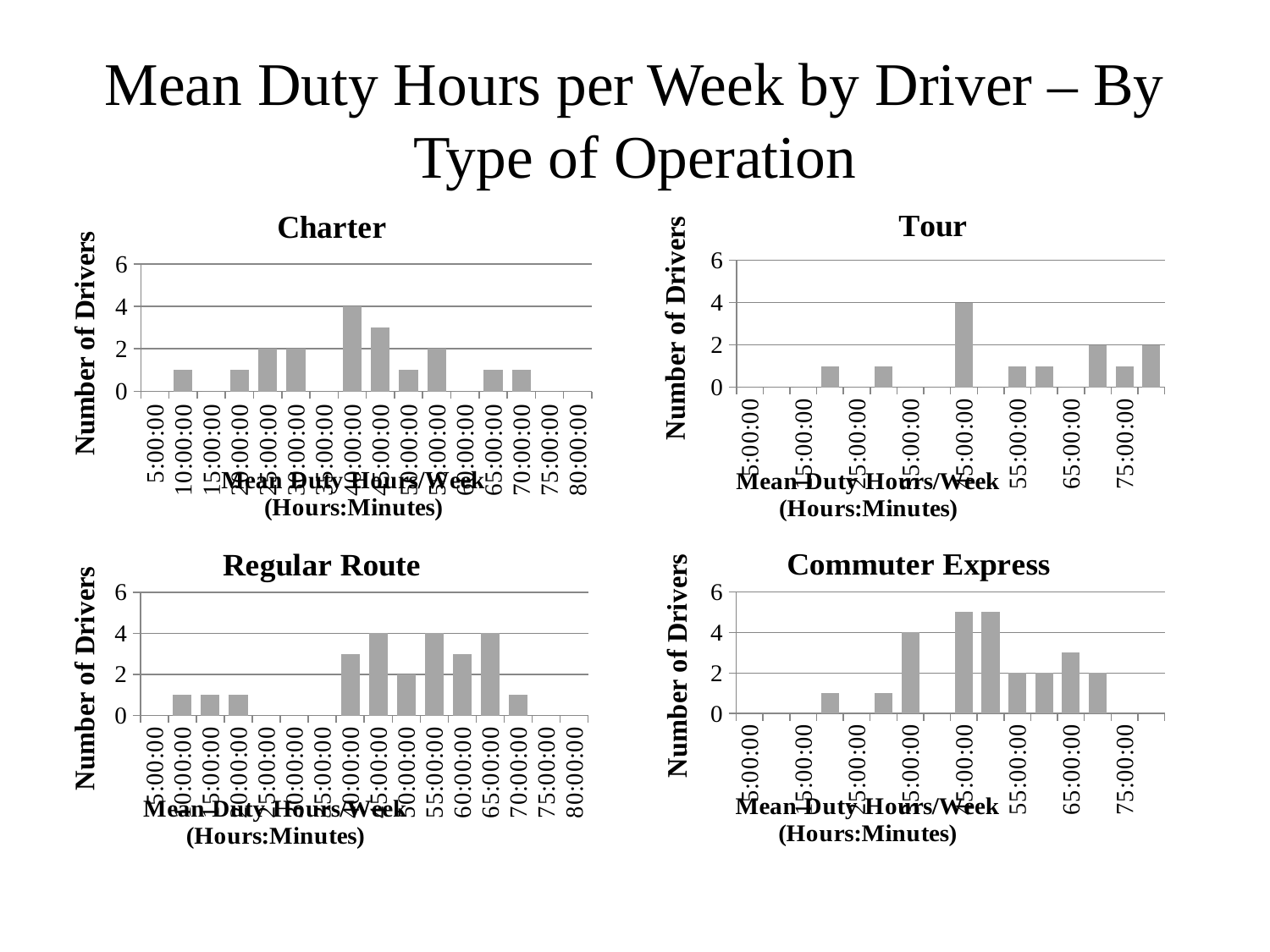
In the Commuter Express chart, is the number of drivers for 45:00:00 greater or less than 4? greater In the Charter chart, what is the difference in number of drivers between the 40:00:00 and 25:00:00 categories? 2 In the Charter chart, how many drivers are in the 25:00:00 category? 2 How many charts are shown on the slide? 4 In the Commuter Express chart, how many drivers are in the 35:00:00 category? 4 In the Regular Route chart, how many drivers are in the 50:00:00 category? 2 In the Charter chart, how many drivers are in the 40:00:00 category? 4 What kind of chart is the Charter chart? bar chart In the Tour chart, which mean duty hours category has the highest number of drivers? 45:00:00 In the Tour chart, how many drivers are in the 45:00:00 category? 4 In the Charter chart, which mean duty hours category has the highest number of drivers? 40:00:00 In the Tour chart, is the number of drivers for 75:00:00 greater or less than 2? less